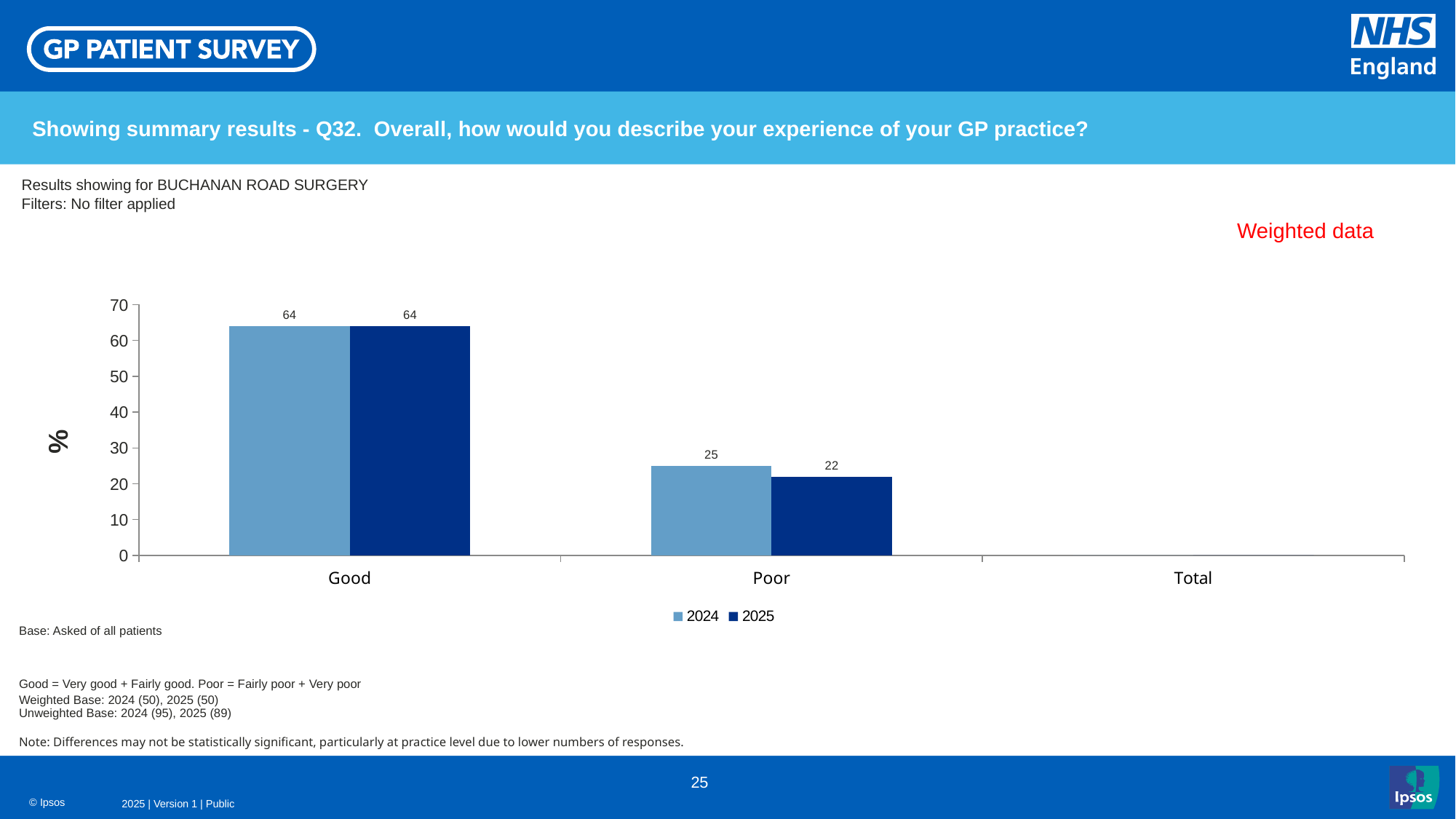
What is the difference between the Good and Poor values for 2025? 42 What kind of chart is shown? Bar chart What is the difference between the 2024 and 2025 values for Poor? 3 What is the label on the vertical axis? % What is the value for Good in 2025? 64 Which is larger for 2024: Good or Poor? Good Is the value for Good in 2025 greater or less than 60? greater What is the value for Poor in 2025? 22 What is the value for Poor in 2024? 25 Which year has the higher value for Poor? 2024 How many series does the legend list? 2 What is the value for Good in 2024? 64